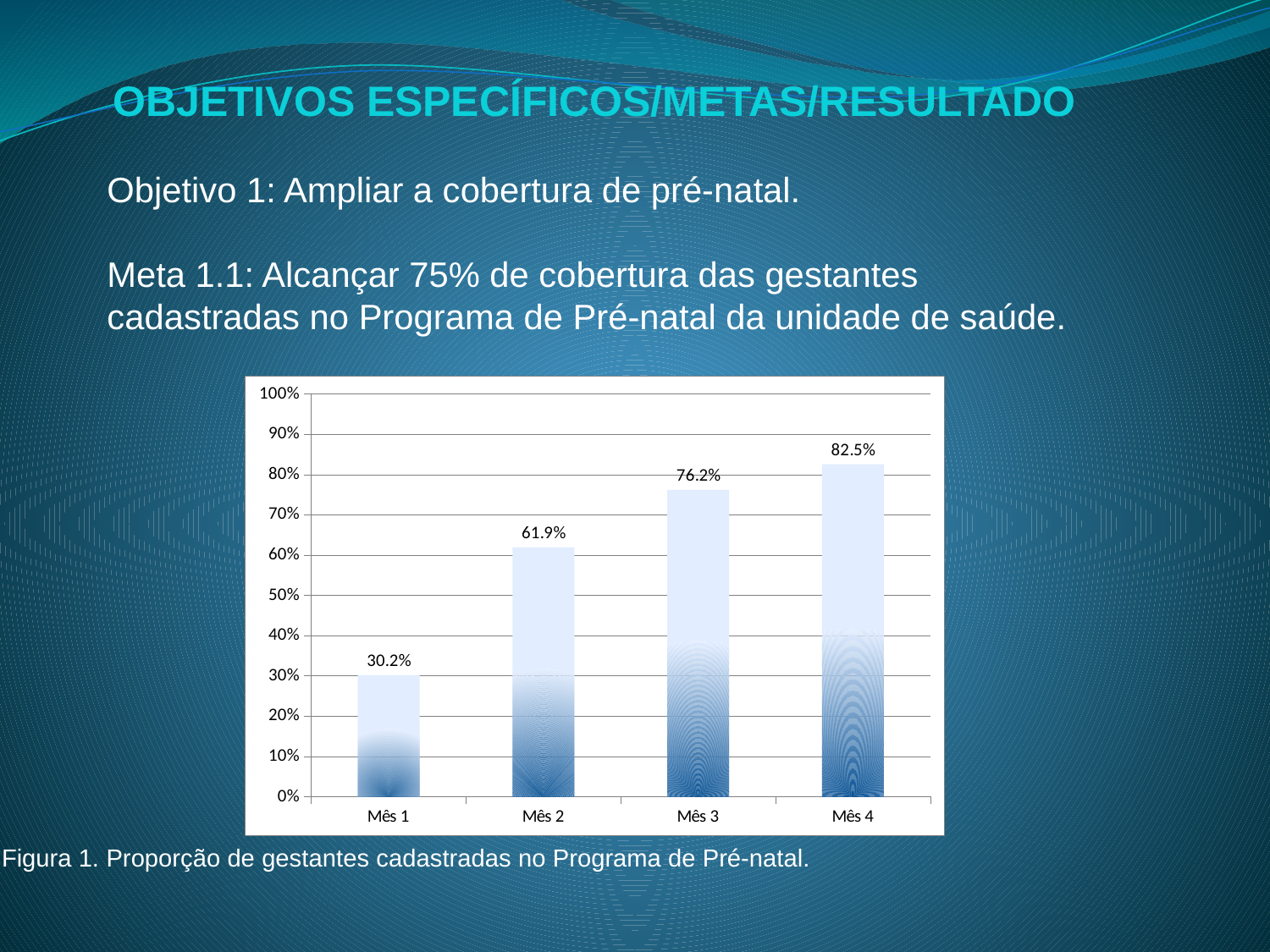
Which is larger, the value for Mês 2 or the value for Mês 3? Mês 3 What kind of chart is shown on the slide? bar chart What is the value for Mês 3? 76.2% Which month has the highest value? Mês 4 Is the value for Mês 2 greater or less than 60%? greater What is the difference between the values for Mês 4 and Mês 1? 52.3% What is the difference between the values for Mês 3 and Mês 2? 14.3% Do the values rise or fall from Mês 1 to Mês 4? rise What is the value for Mês 1? 30.2% Which month has the lowest value? Mês 1 What is the value for Mês 4? 82.5% How many months are shown on the x axis? 4